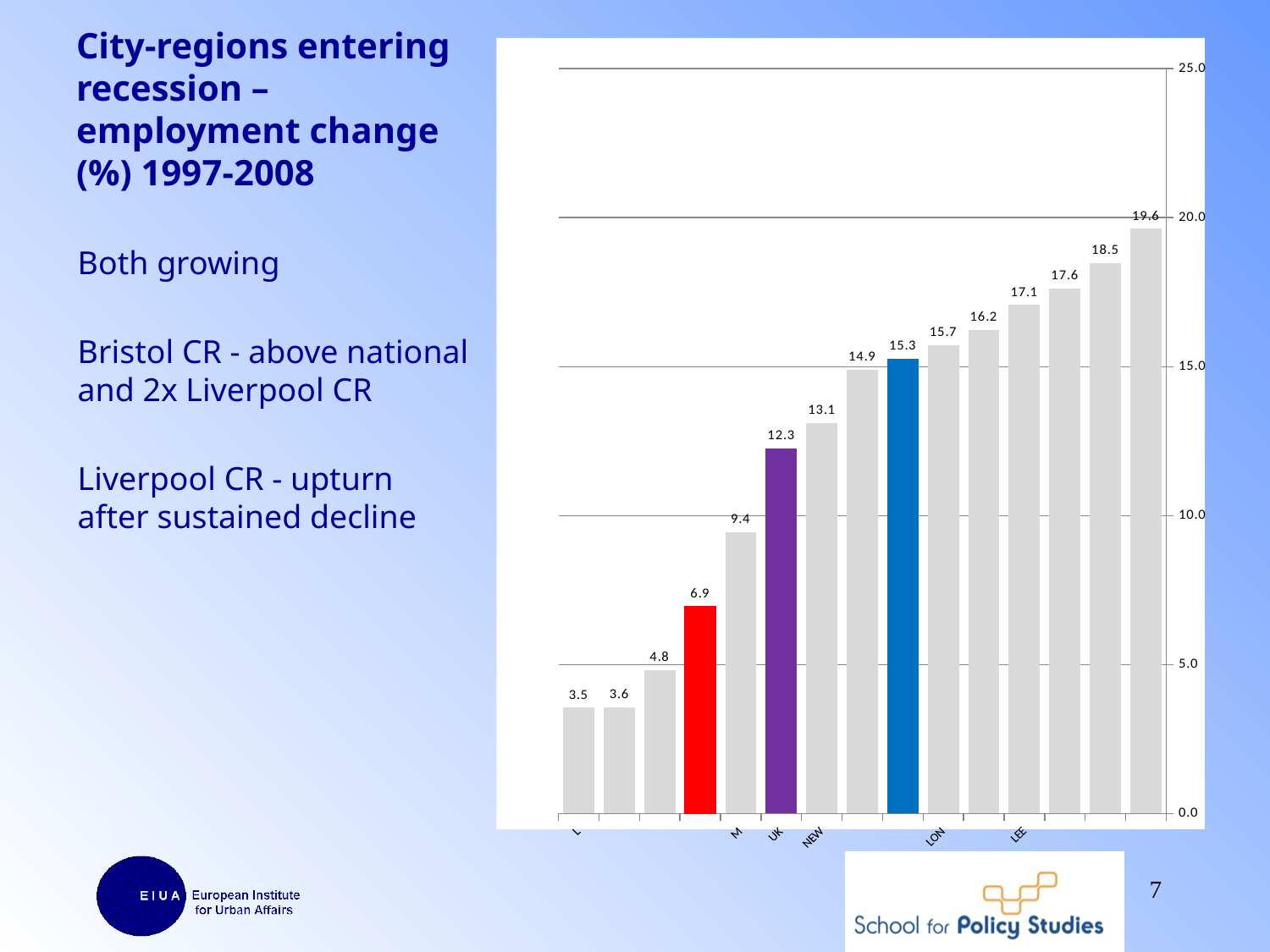
What is the value of the bar labelled UK? 12.3 What is the highest value shown in the chart? 19.6 What is the lowest value shown in the chart? 3.5 Which is larger, the blue bar or the UK bar? the blue bar Do the bar values rise or fall from left to right along the x axis? rise What colour is the bar labelled UK? purple What kind of chart is shown on the slide? bar chart What is the difference between the blue bar and the red bar? 8.4 What is the value of the red bar? 6.9 How many bars are plotted in the chart? 15 What is the value of the blue bar? 15.3 Is the value of the red bar greater or less than 5.0? greater